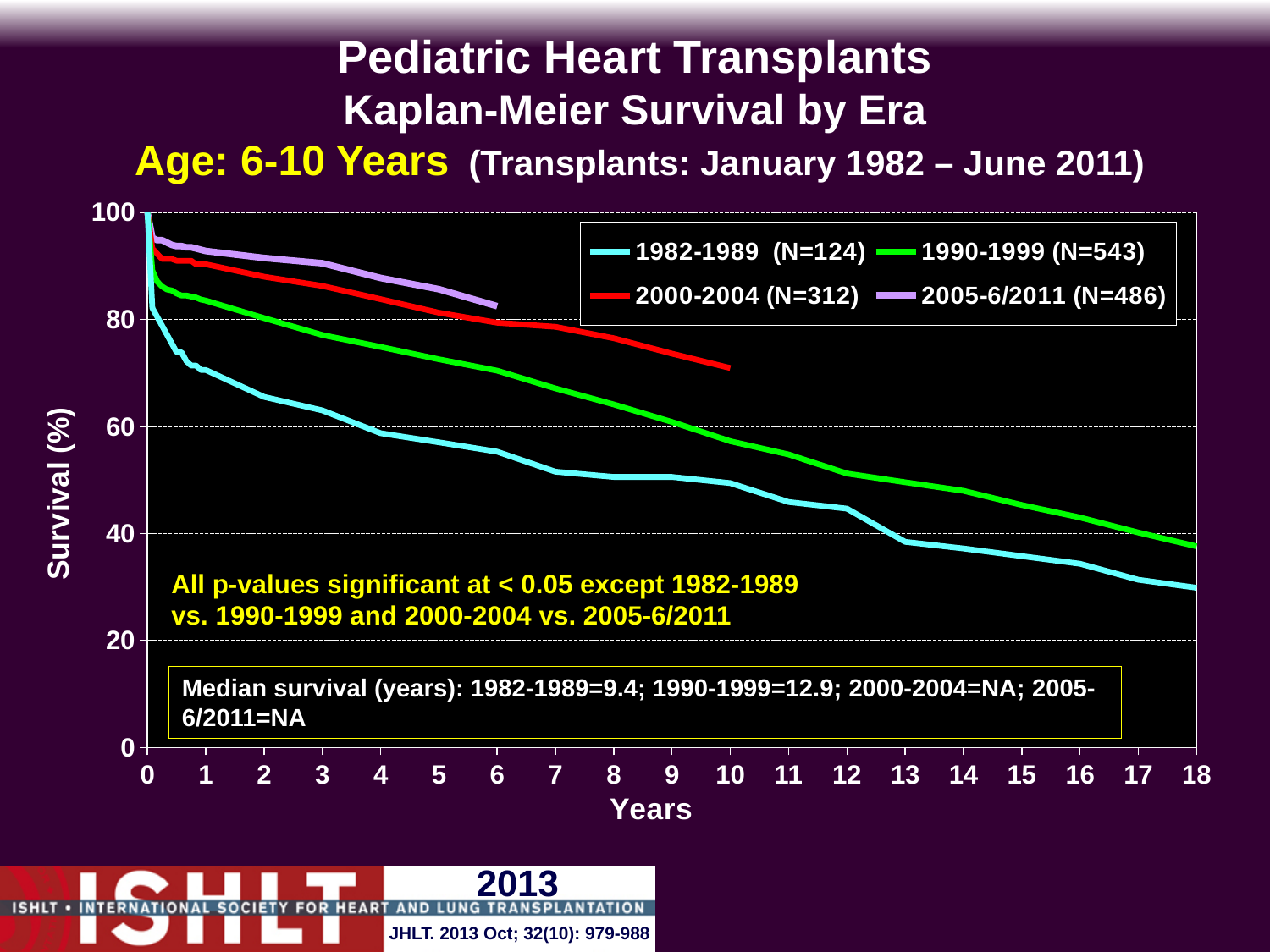
Which era has the lowest survival at 5 years? 1982-1989 How many series does the legend list? 4 At 5 years, which era has higher survival: 2005-6/2011 or 1982-1989? 2005-6/2011 At 10 years, which era has higher survival: 2000-2004 or 1990-1999? 2000-2004 Is the survival for the 2005-6/2011 era at 6 years greater or less than 80? greater What kind of chart is shown on the slide? line chart Is the survival for the 1990-1999 era at 5 years greater or less than 60? greater Is the survival for the 1982-1989 era at 5 years greater or less than 60? less Do the survival curves rise or fall as years increase? fall According to the legend, what is N for the 1982-1989 era? 124